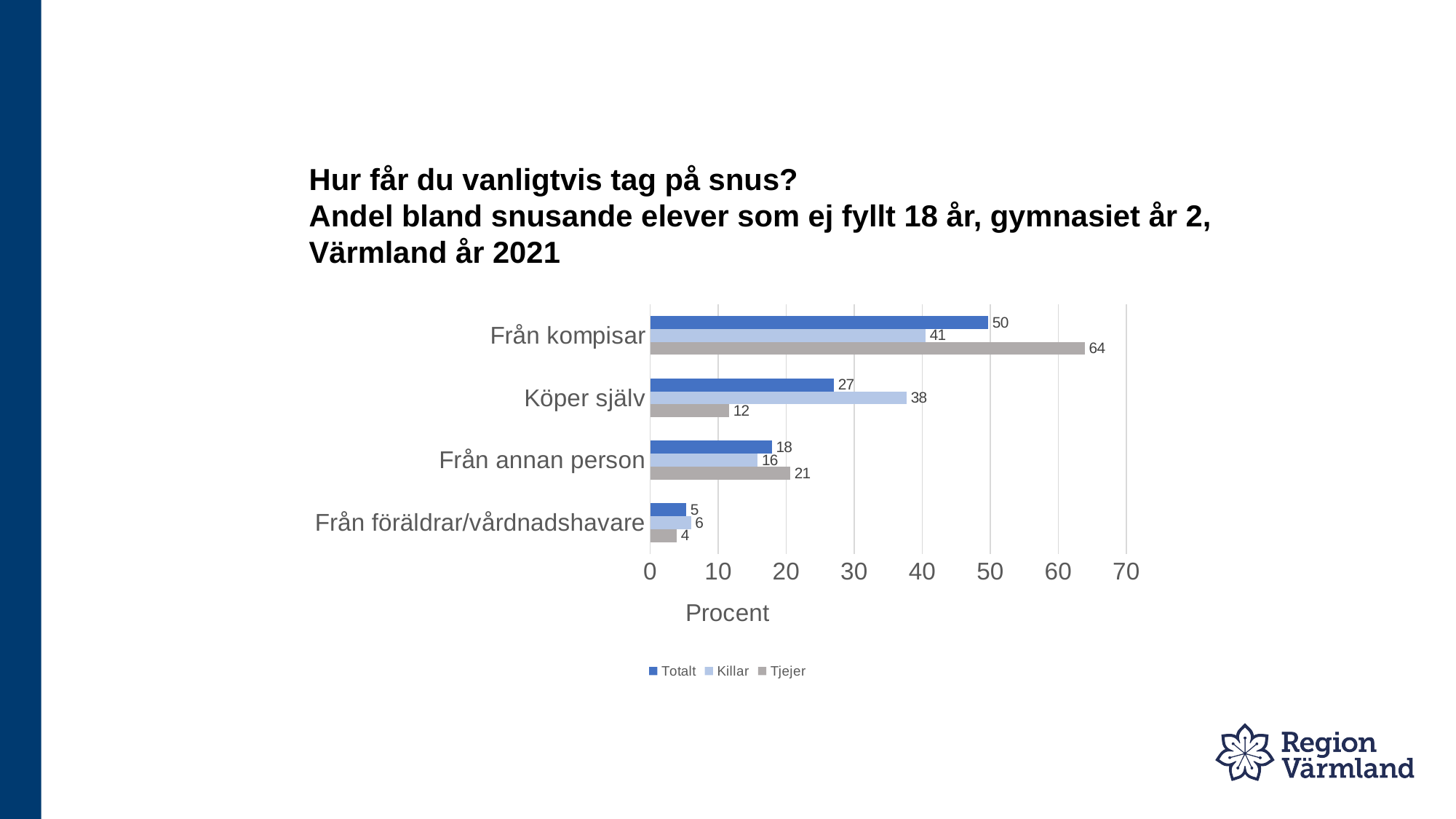
What is the label of the horizontal axis? Procent What is the Tjejer value for Köper själv? 12 What is the Totalt value for Från kompisar? 50 What is the Killar value for Från annan person? 16 What is the difference between the Totalt values for Från kompisar and Köper själv? 23 What is the difference between the Tjejer and Killar values for Från kompisar? 23 What kind of chart is shown on the slide? Bar chart How many categories are shown on the chart? 4 Which category has the highest Tjejer value? Från kompisar How many series does the legend list? 3 For Köper själv, which is larger: the Killar value or the Tjejer value? Killar Which category has the lowest Totalt value? Från föräldrar/vårdnadshavare